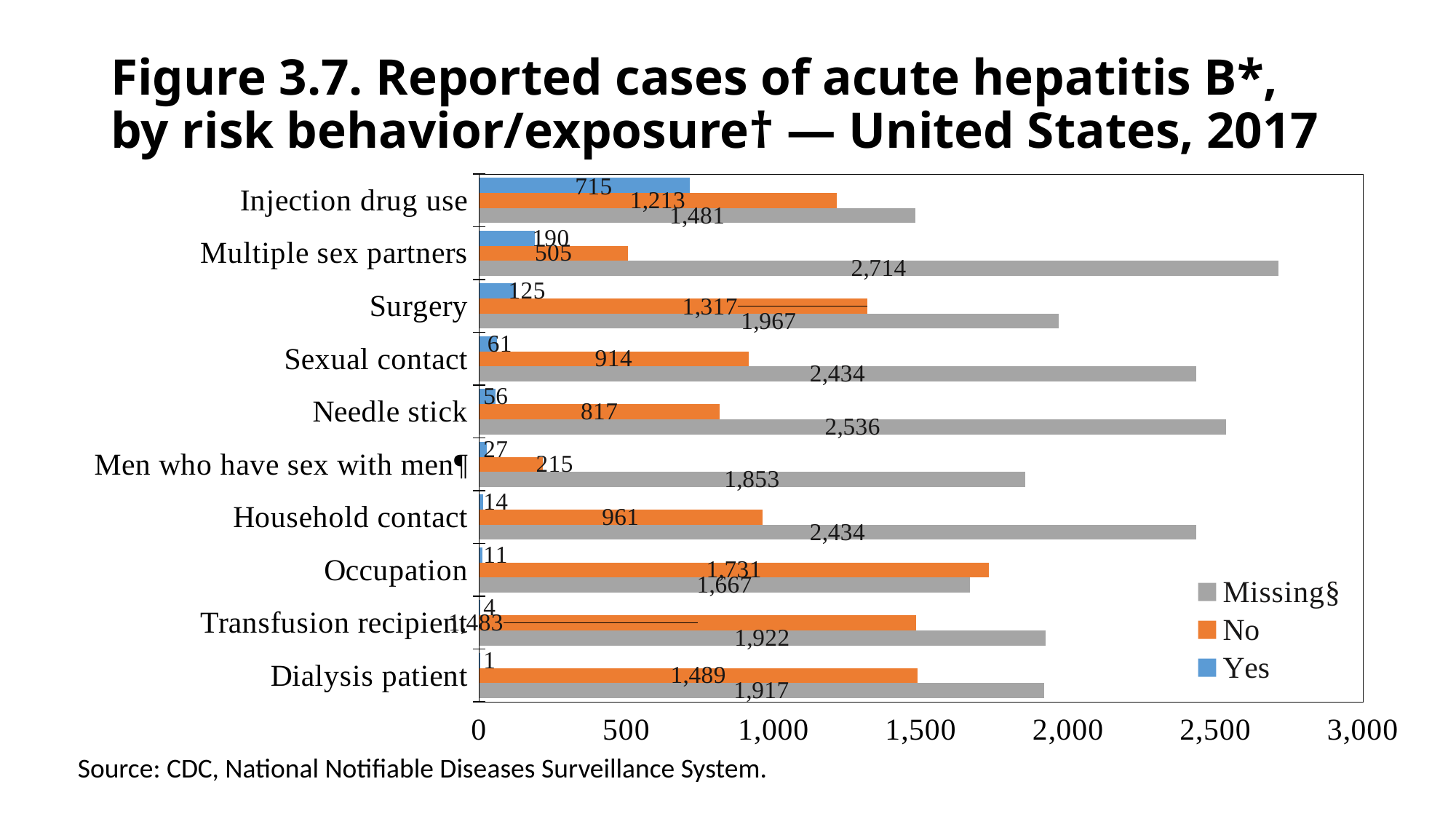
What kind of chart is shown on the slide? Bar chart What is the value of the Missing§ series for Multiple sex partners? 2,714 How many series does the legend list? 3 Is the Missing§ value for Needle stick greater or less than 2,500? greater For Occupation, which is larger: the No value or the Missing§ value? No Which category has the highest value in the Yes series? Injection drug use Which category has the lowest value in the Yes series? Dialysis patient How many risk behavior/exposure categories are shown on the chart? 10 What is the value of the Yes series for Injection drug use? 715 What is the difference between the No and Yes values for Injection drug use? 498 What is the value of the No series for Household contact? 961 Which category has the highest value in the Missing§ series? Multiple sex partners